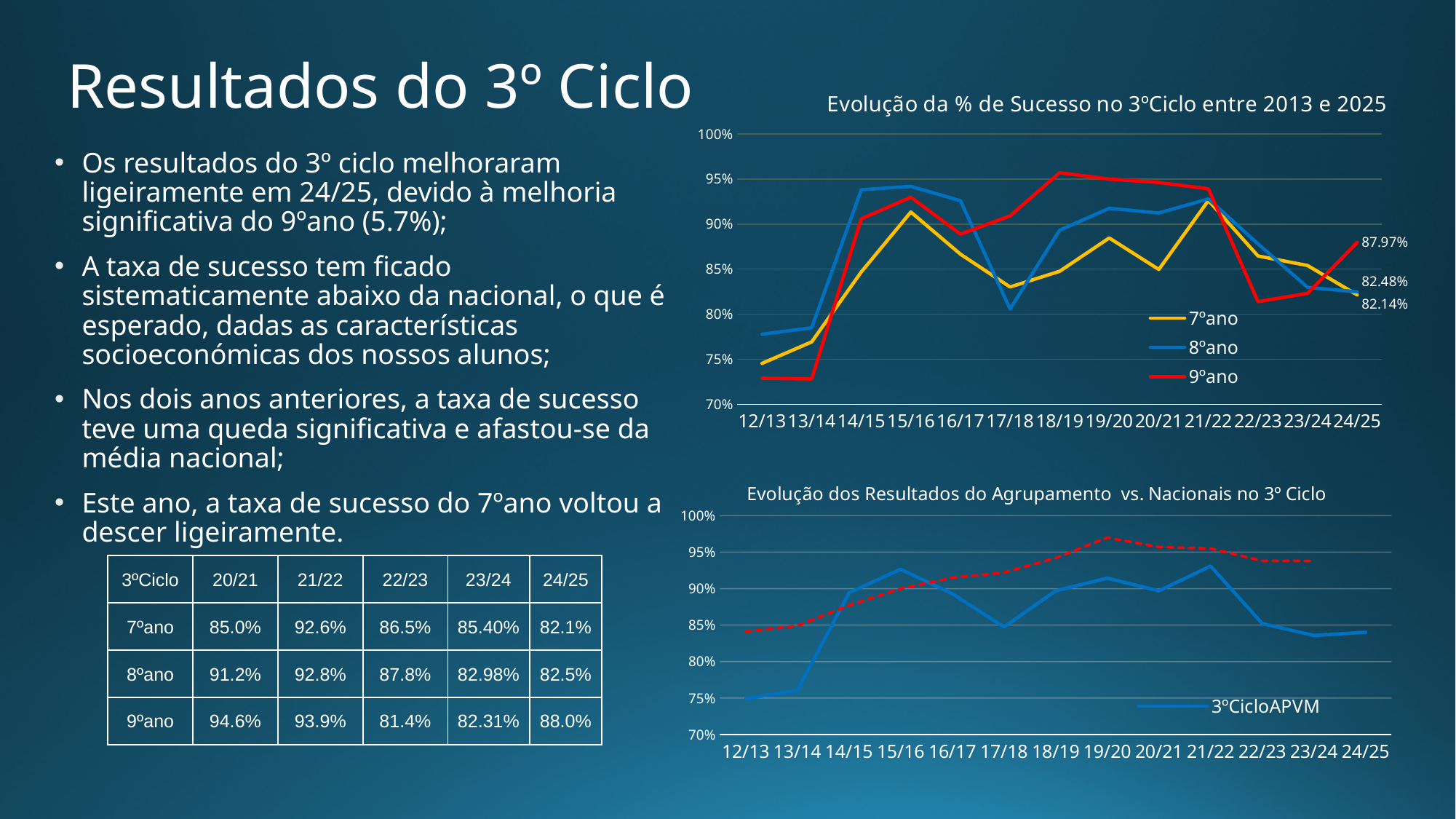
How many series does the legend of the top chart list? 3 How many school years are shown on the x axis of the top chart? 13 In the top chart, what is the difference between the 9ºano and 8ºano values in 24/25? 5.49 percentage points In the bottom chart, does the 3ºCicloAPVM line rise or fall from 21/22 to 23/24? fall In the top chart, is the value for 8ºano in 14/15 greater or less than 90%? greater In the top chart, what is the value for 7ºano in 24/25? 82.14% In the bottom chart, 'Evolução dos Resultados do Agrupamento vs. Nacionais no 3º Ciclo', is the value for 3ºCicloAPVM in 12/13 greater or less than 80%? less In the top chart, what is the value for 9ºano in 24/25? 87.97% In the top chart, is the value for 9ºano in 12/13 greater or less than 75%? less In the top chart, which series has the highest value in 24/25? 9ºano What kind of chart is the top chart, 'Evolução da % de Sucesso no 3ºCiclo entre 2013 e 2025'? Line chart In the top chart, what is the value for 8ºano in 24/25? 82.48%